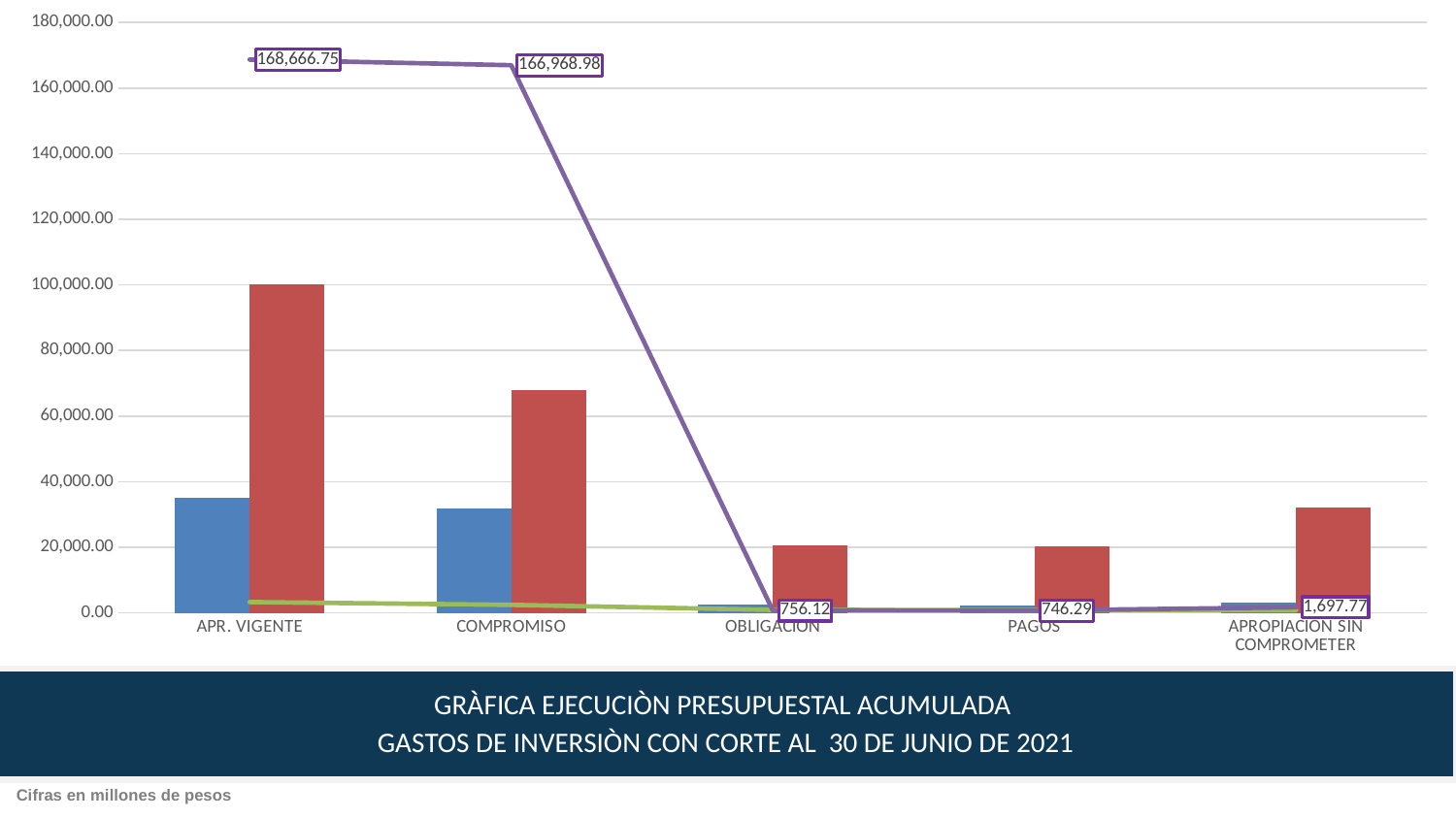
Is the blue bar for APR. VIGENTE greater or less than 40,000.00? less On the purple line, which is larger: the value for OBLIGACION or the value for PAGOS? OBLIGACION What value does the purple line show for COMPROMISO? 166,968.98 What value does the purple line show for APR. VIGENTE? 168,666.75 What is the difference between the purple line values for APR. VIGENTE and COMPROMISO? 1,697.77 What value does the purple line show for OBLIGACION? 756.12 How many categories are shown on the x axis? 5 What value does the purple line show for APROPIACION SIN COMPROMETER? 1,697.77 Is the red bar for APR. VIGENTE greater or less than 80,000.00? greater Which category has the highest value on the purple line? APR. VIGENTE Which category has the lowest value on the purple line? PAGOS Which category has the tallest red bar? APR. VIGENTE